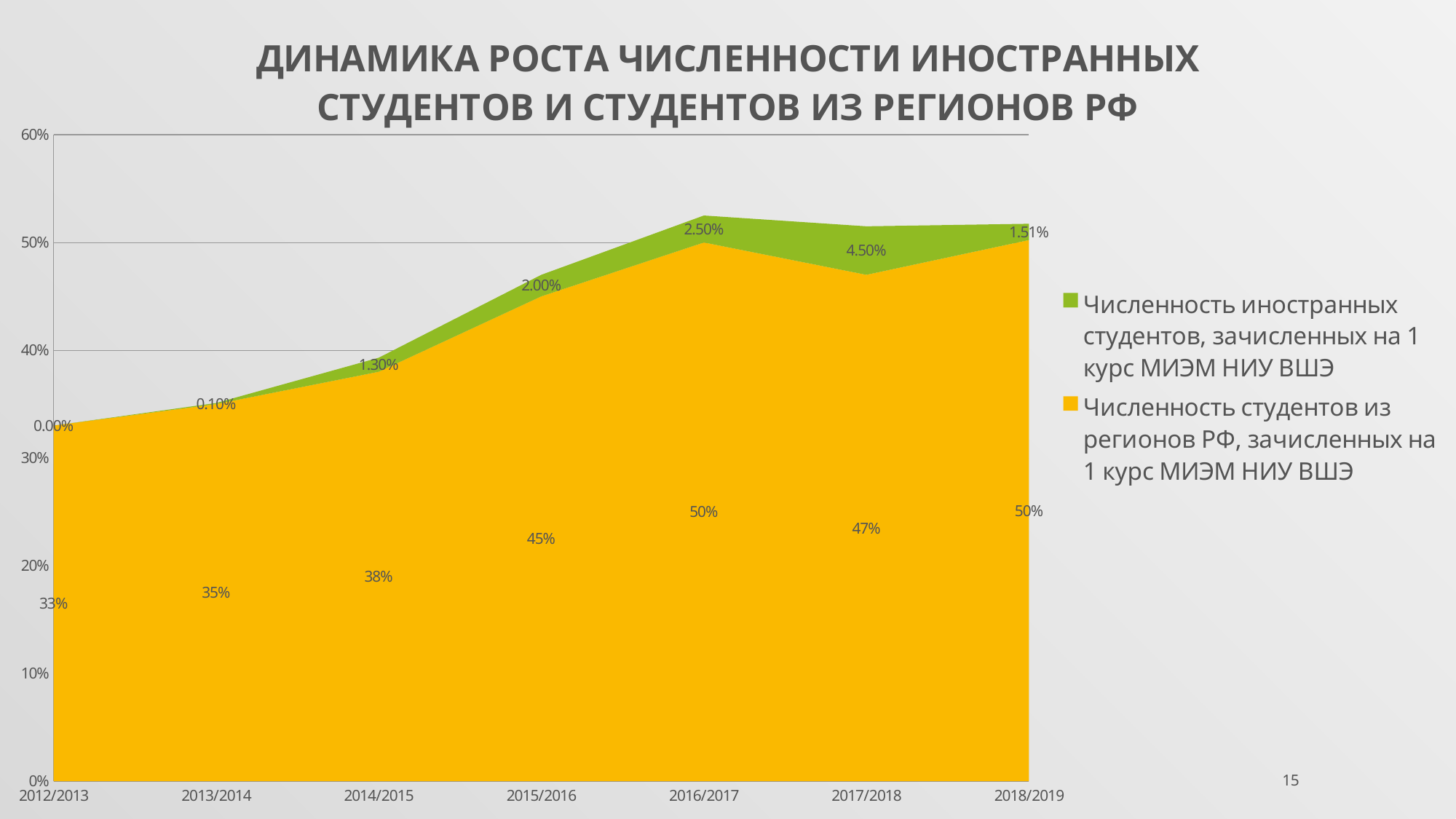
What is the difference between the values for students from RF regions in 2015/2016 and 2014/2015? 7% Which is larger: the foreign students value in 2017/2018 or in 2018/2019? 2017/2018 What is the value for foreign students in 2018/2019? 1.51% In which academic year is the share of foreign students the highest? 2017/2018 What is the combined total of the two series in 2016/2017? 52.50% Does the share of students from RF regions rise or fall from 2012/2013 to 2016/2017? Rise What type of chart is shown on the slide? Area chart How many series does the legend list? 2 How many academic years are shown on the x axis? 7 What is the value for foreign students (Численность иностранных студентов) in 2017/2018? 4.50% In which academic year is the share of students from RF regions the lowest? 2012/2013 What is the value for students from RF regions (Численность студентов из регионов РФ) in 2015/2016? 45%